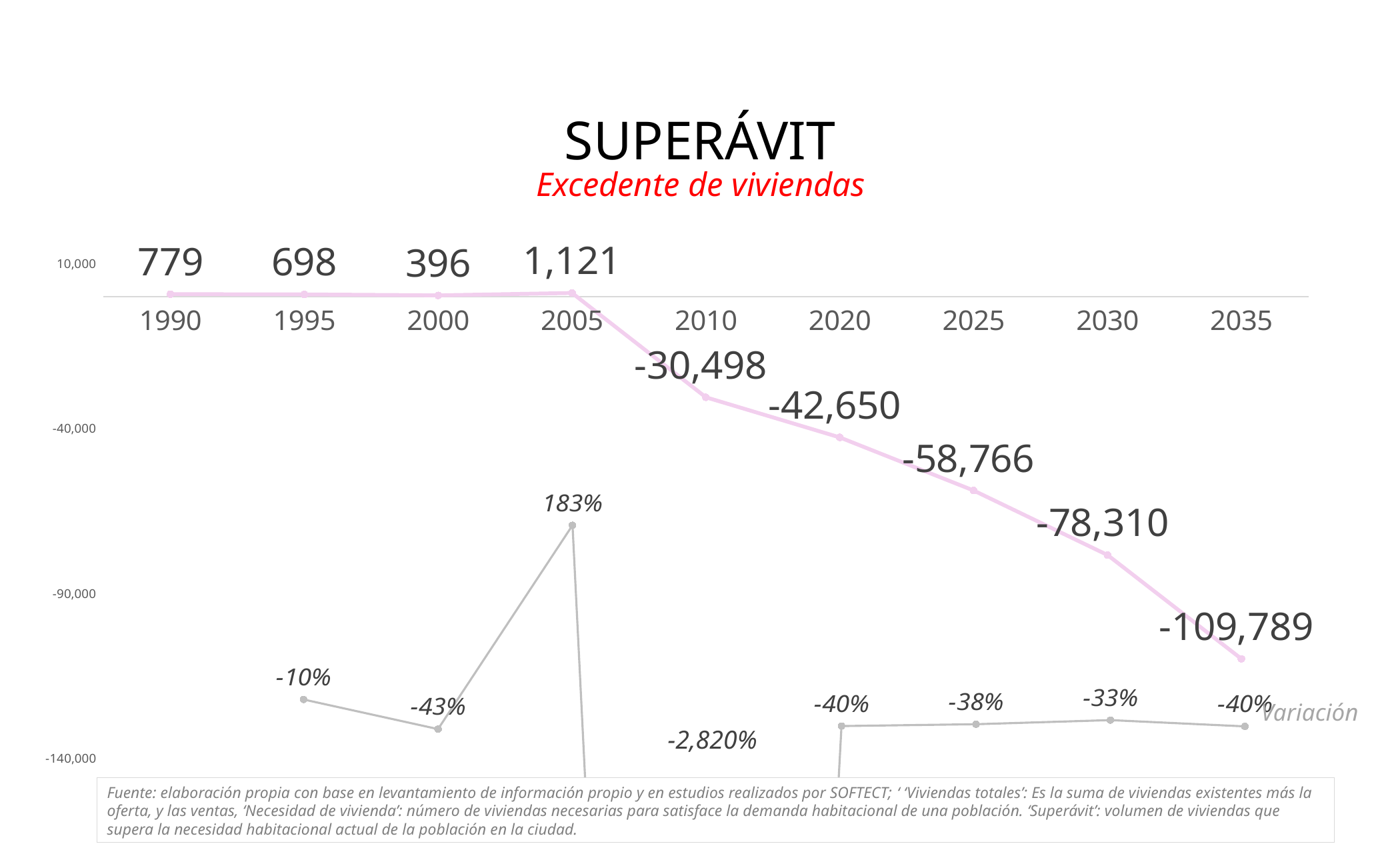
Which is larger, the superávit value for 2020 or for 2025? 2020 What is the Variación value for 2010? -2,820% Do the superávit values rise or fall from 2005 to 2035? Fall What is the Variación value for 2005? 183% What kind of chart is shown on the slide? Line chart What is the difference between the superávit values for 1990 and 1995? 81 Which year has the lowest superávit value? 2035 Which year has the highest superávit value? 2005 What is the superávit value for 2005? 1,121 What is the superávit value for 2010? -30,498 What is the superávit value for 2035? -109,789 How many years are shown on the x axis of the chart? 9